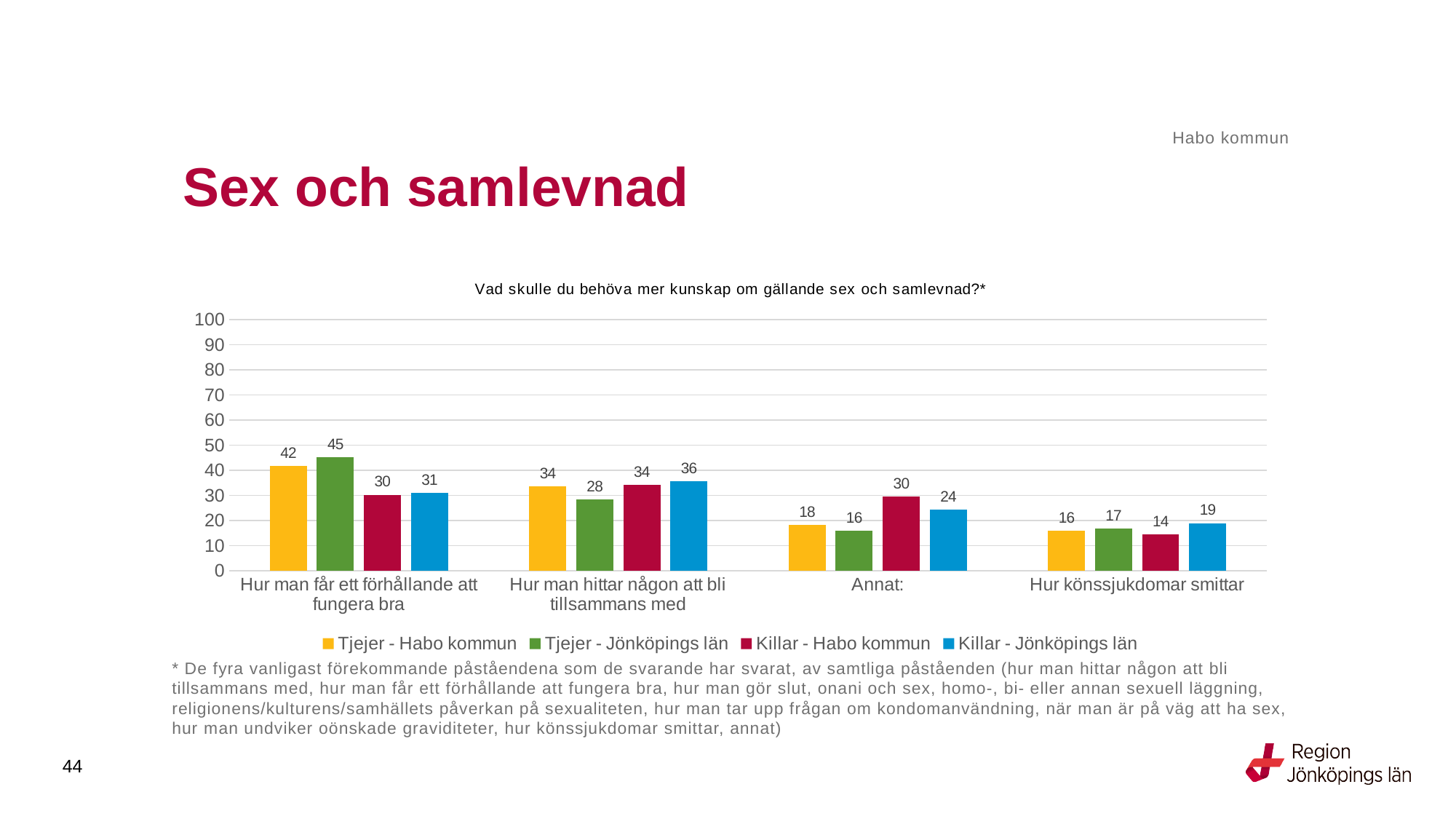
What is the value for Tjejer - Jönköpings län in the category 'Hur man får ett förhållande att fungera bra'? 45 How many series does the legend list? 4 What is the value for Killar - Jönköpings län in the category 'Hur man hittar någon att bli tillsammans med'? 36 Is the value for Tjejer - Habo kommun in 'Hur man får ett förhållande att fungera bra' greater or less than 40? greater Which category has the lowest value for Killar - Habo kommun? Hur könssjukdomar smittar What kind of chart is shown on the slide? bar chart What is the title of the chart? Vad skulle du behöva mer kunskap om gällande sex och samlevnad?* What is the difference between Tjejer - Habo kommun and Tjejer - Jönköpings län in the category 'Hur man hittar någon att bli tillsammans med'? 6 How many categories are shown on the x axis? 4 What is the value for Killar - Habo kommun in the category 'Annat:'? 30 In the category 'Annat:', which is larger: Killar - Habo kommun or Killar - Jönköpings län? Killar - Habo kommun Which category has the highest value for Tjejer - Habo kommun? Hur man får ett förhållande att fungera bra